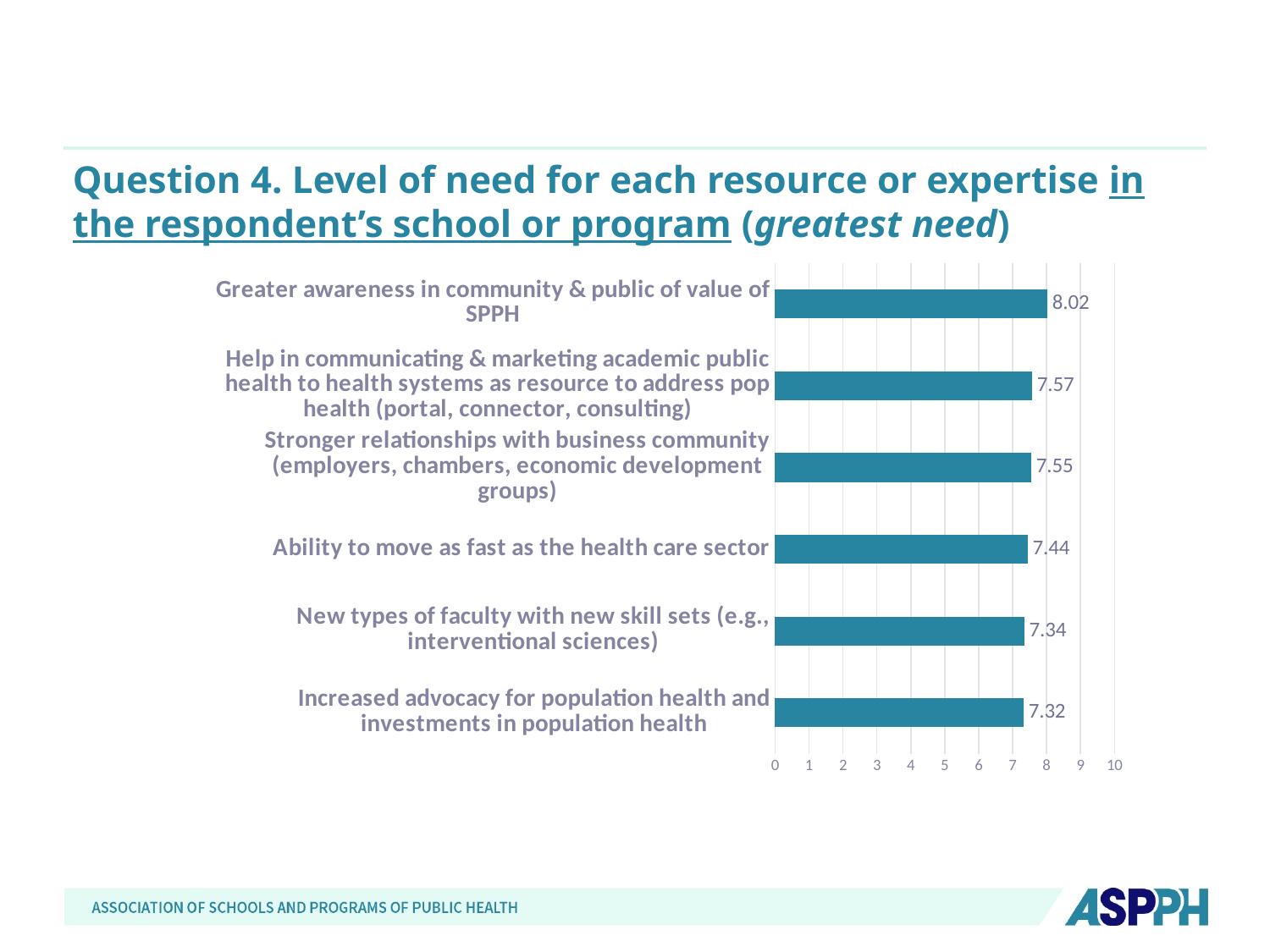
Which has a larger value: "Greater awareness in community & public of value of SPPH" or "Ability to move as fast as the health care sector"? Greater awareness in community & public of value of SPPH Which category has the highest value? Greater awareness in community & public of value of SPPH What kind of chart is shown on the slide? Bar chart What is the difference between the value for "Greater awareness in community & public of value of SPPH" and the value for "Increased advocacy for population health and investments in population health"? 0.70 What is the value for "Greater awareness in community & public of value of SPPH"? 8.02 How many categories are shown in the chart? 6 What is the value for "New types of faculty with new skill sets (e.g., interventional sciences)"? 7.34 What is the value for "Ability to move as fast as the health care sector"? 7.44 What is the difference between the value for "Help in communicating & marketing academic public health to health systems as resource to address pop health (portal, connector, consulting)" and the value for "Ability to move as fast as the health care sector"? 0.13 What is the value for "Increased advocacy for population health and investments in population health"? 7.32 Which category has the lowest value? Increased advocacy for population health and investments in population health What is the maximum value shown on the horizontal axis? 10